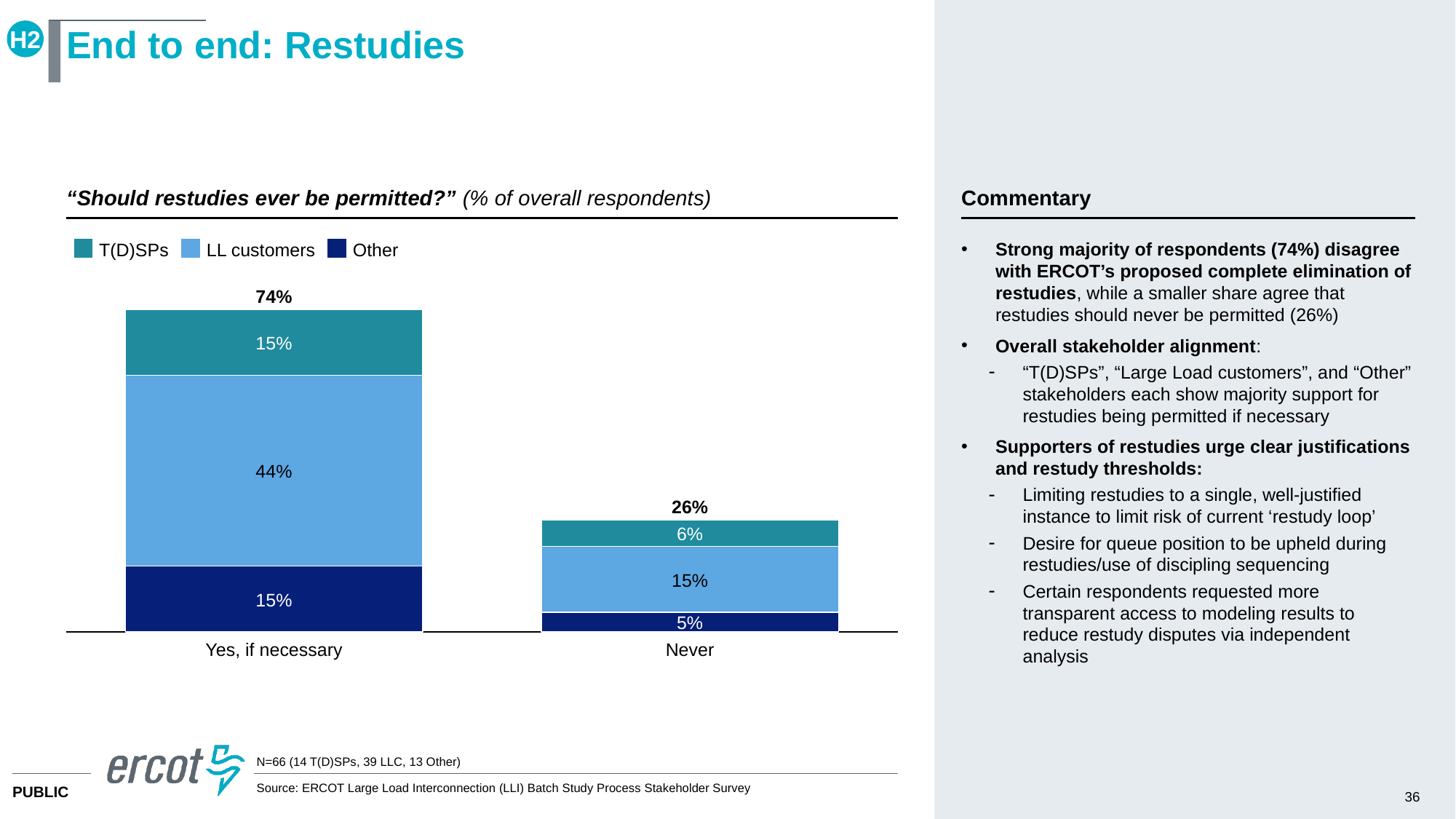
What is the difference between the LL customers values for 'Yes, if necessary' and 'Never'? 29% Which series has the largest segment in the 'Yes, if necessary' bar? LL customers What is the total for the 'Yes, if necessary' bar? 74% What kind of chart is shown on the slide? Stacked bar chart What is the value for T(D)SPs in the 'Never' bar? 6% What is the total for the 'Never' bar? 26% What is the title of the chart? "Should restudies ever be permitted?" (% of overall respondents) How many series does the legend list? 3 Which category has the higher total, 'Yes, if necessary' or 'Never'? Yes, if necessary What is the value for Other in the 'Never' bar? 5% How many categories are shown on the x axis? 2 What is the value for LL customers in the 'Yes, if necessary' bar? 44%